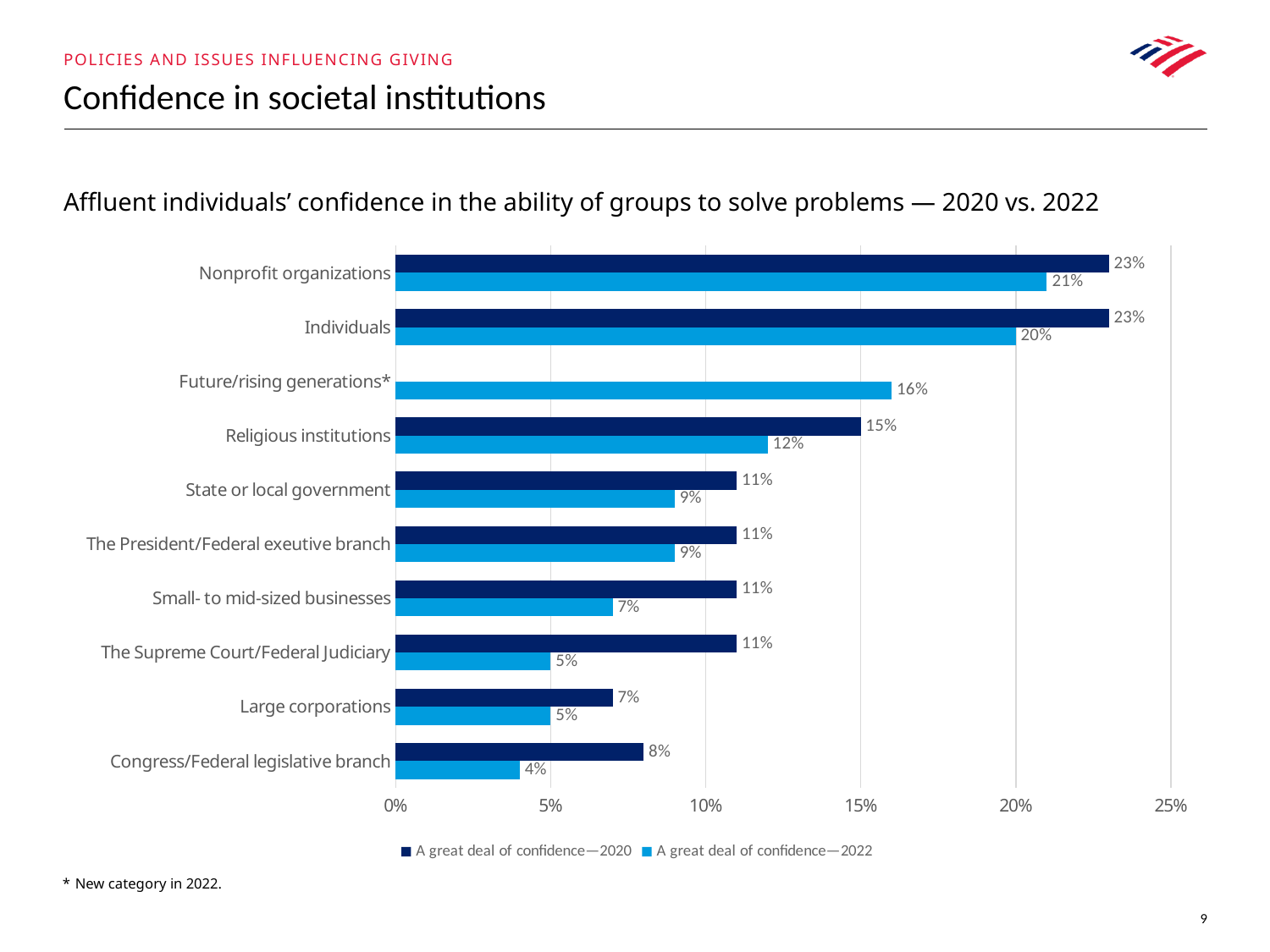
Which is larger: the 2022 value for Future/rising generations* or the 2022 value for Religious institutions? Future/rising generations* What is the difference between the 2020 and 2022 values for The Supreme Court/Federal Judiciary? 6% What is the 2022 value for Nonprofit organizations? 21% How many series does the legend list? 2 What is the 2020 value for Religious institutions? 15% What is the 2022 value for Small- to mid-sized businesses? 7% Which category has no 2020 value shown? Future/rising generations* Is the 2020 value for Individuals greater or less than 20%? greater What is the 2022 value for Congress/Federal legislative branch? 4% What kind of chart is shown on the slide? Bar chart How many categories are shown on the chart? 10 Which category has the lowest 2022 value? Congress/Federal legislative branch